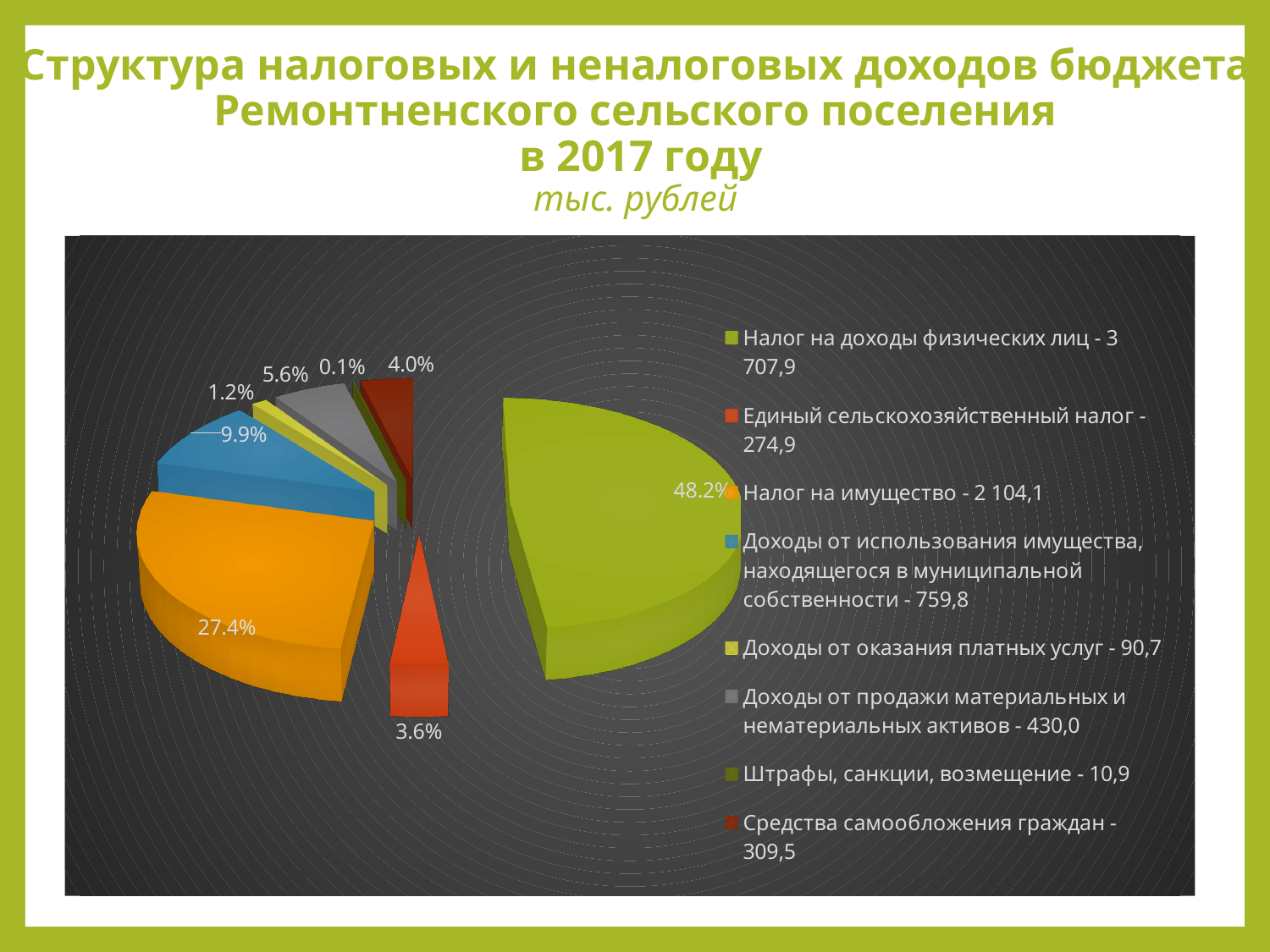
What value (тыс. рублей) does the legend give for 'Доходы от использования имущества, находящегося в муниципальной собственности'? 759,8 What share of the pie does 'Единый сельскохозяйственный налог' have? 3.6% What kind of chart is shown on the slide? pie chart Which is larger: the share for 'Доходы от продажи материальных и нематериальных активов' or the share for 'Средства самообложения граждан'? Доходы от продажи материальных и нематериальных активов What share of the pie does 'Налог на имущество' have? 27.4% How many slices does the pie chart have? 8 What is the difference in percentage points between the share of 'Налог на доходы физических лиц' and the share of 'Налог на имущество'? 20.8 What share of the pie does 'Штрафы, санкции, возмещение' have? 0.1% Which category has the smallest slice of the pie? Штрафы, санкции, возмещение Which category has the largest slice of the pie? Налог на доходы физических лиц What value (тыс. рублей) does the legend give for 'Средства самообложения граждан'? 309,5